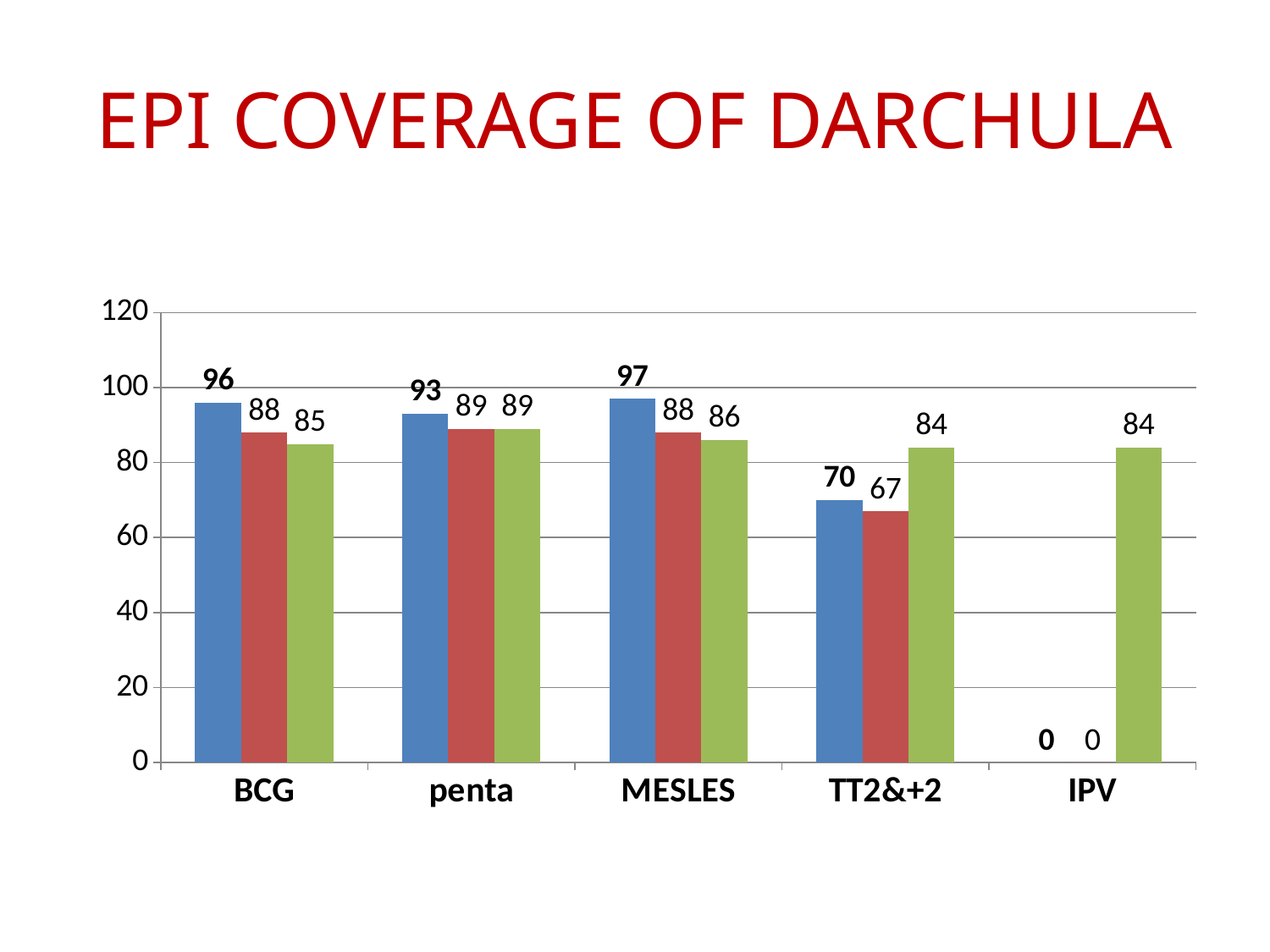
How many categories are shown on the x axis? 5 Which category has the highest blue bar? MESLES What kind of chart is shown on the slide? bar chart What is the value of the blue bar for BCG? 96 Which category has the lowest red bar? IPV What is the difference between the blue bar and the red bar for TT2&+2? 3 What is the difference between the green bar for penta and the green bar for BCG? 4 What is the value of the blue bar for IPV? 0 What is the value of the green bar for TT2&+2? 84 What is the title of the slide? EPI COVERAGE OF DARCHULA What is the value of the red bar for penta? 89 Which is larger for MESLES, the red bar or the green bar? the red bar